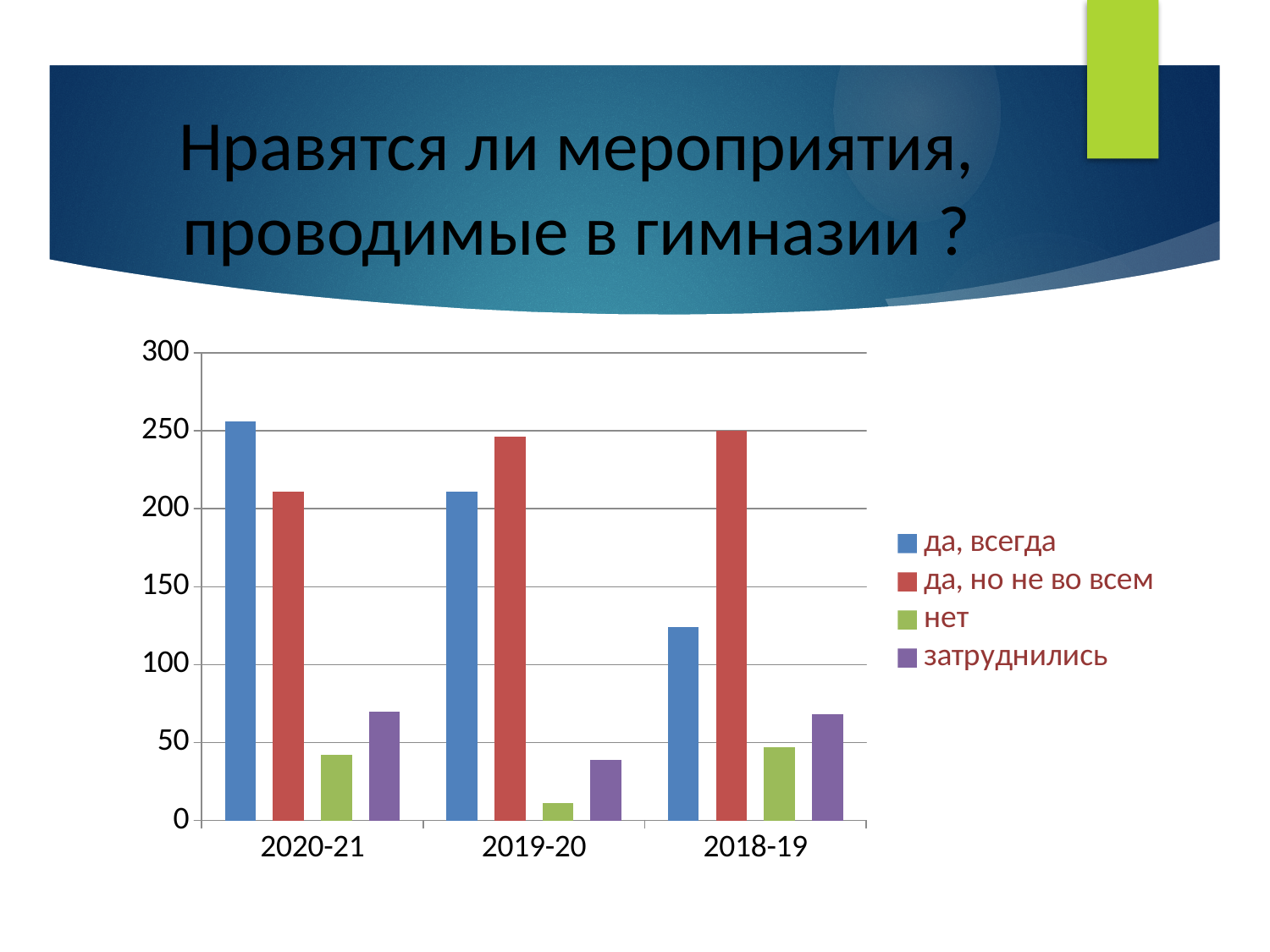
Is the value for "да, всегда" in 2018-19 greater or less than 100? greater Which school year has the lowest value for "да, всегда"? 2018-19 Which school year has the lowest value for "нет"? 2019-20 Is the value for "да, но не во всем" in 2019-20 greater or less than 200? greater What kind of chart is shown on the slide? bar chart Does the value for "да, всегда" rise or fall from 2020-21 to 2018-19 along the x axis? fall In 2020-21, which is larger: "да, всегда" or "да, но не во всем"? да, всегда How many categories (school years) are shown on the x axis? 3 In 2018-19, which is larger: "да, всегда" or "да, но не во всем"? да, но не во всем Is the value for "нет" in 2019-20 greater or less than 50? less How many series does the legend list? 4 Which school year has the highest value for "да, всегда"? 2020-21